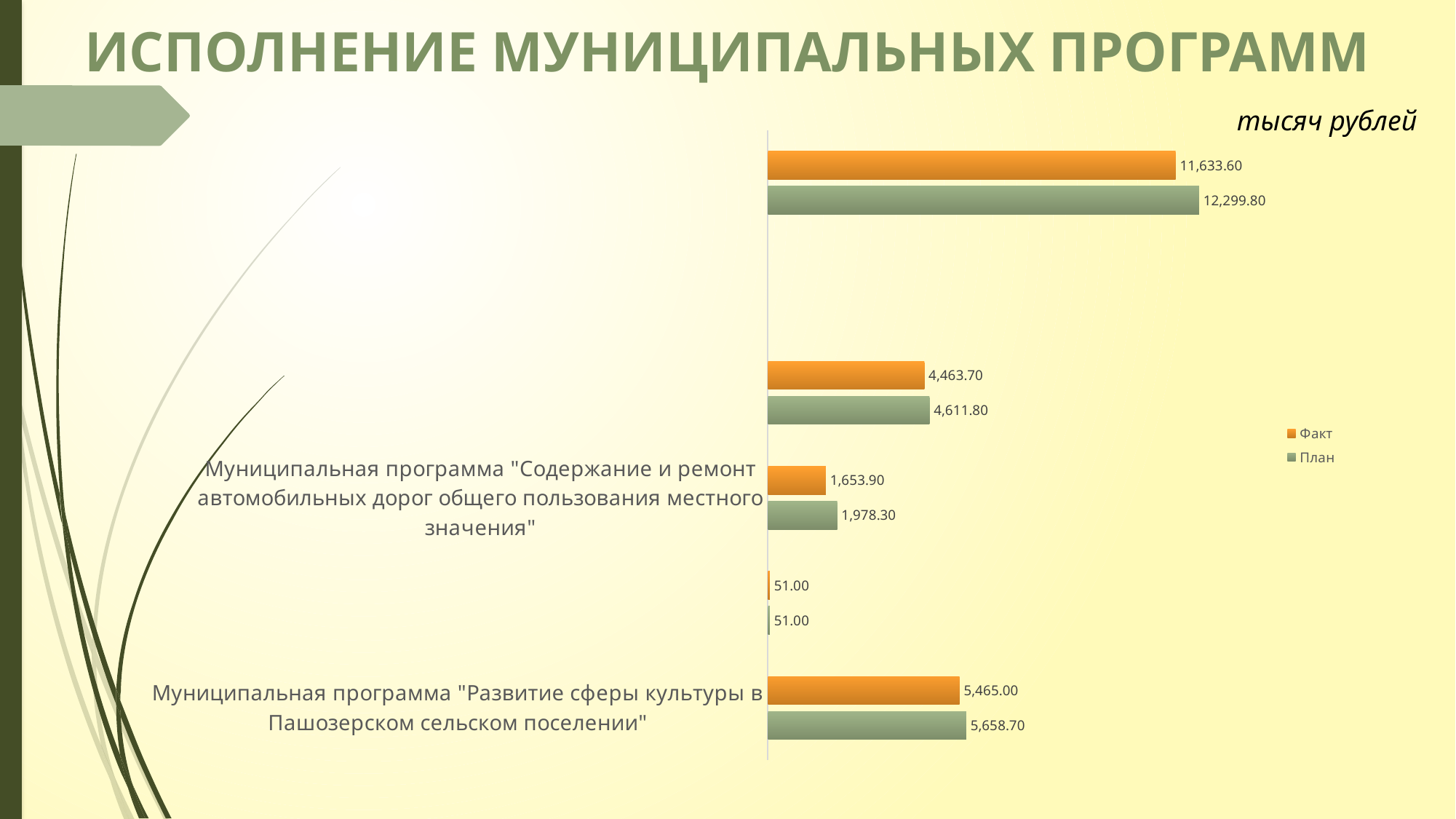
What is the lowest План value shown on the chart? 51.00 How many series does the legend list? 2 What is the highest Факт value shown on the chart? 11,633.60 What is the Факт value for the municipal programme "Содержание и ремонт автомобильных дорог общего пользования местного значения"? 1,653.90 For the programme "Развитие сферы культуры в Пашозерском сельском поселении", which is larger: Факт or План? План What type of chart is shown on the slide? Bar chart What is the difference between the План and Факт values for the programme "Содержание и ремонт автомобильных дорог общего пользования местного значения"? 324.40 What is the План value for the municipal programme "Содержание и ремонт автомобильных дорог общего пользования местного значения"? 1,978.30 What is the Факт value for the municipal programme "Развитие сферы культуры в Пашозерском сельском поселении"? 5,465.00 In what units are the values on the chart expressed? тысяч рублей What is the План value for the municipal programme "Развитие сферы культуры в Пашозерском сельском поселении"? 5,658.70 What is the difference between the План and Факт values for the programme "Развитие сферы культуры в Пашозерском сельском поселении"? 193.70